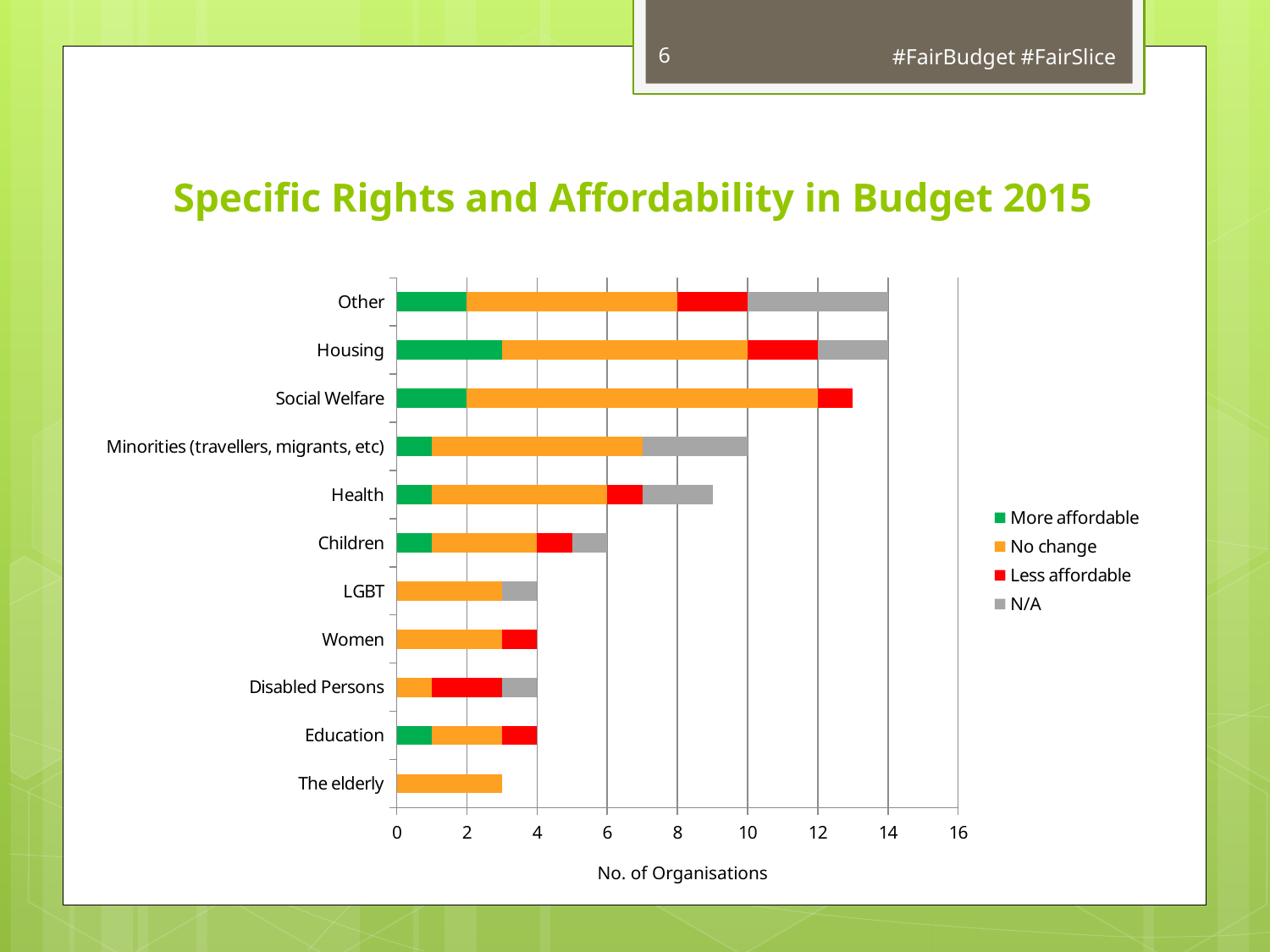
What kind of chart is shown on the slide? Stacked bar chart What is the total number of organisations for the Housing bar? 14 What is the total number of organisations for the Minorities (travellers, migrants, etc) bar? 10 Is the total value for Social Welfare greater or less than 12? greater What is the total number of organisations for the Children bar? 6 What is the title of the chart? Specific Rights and Affordability in Budget 2015 Which has a larger total bar, Social Welfare or Minorities (travellers, migrants, etc)? Social Welfare How many categories are shown on the vertical axis? 11 What is the label of the horizontal axis? No. of Organisations How many series does the legend list? 4 Which category has the shortest total bar? The elderly